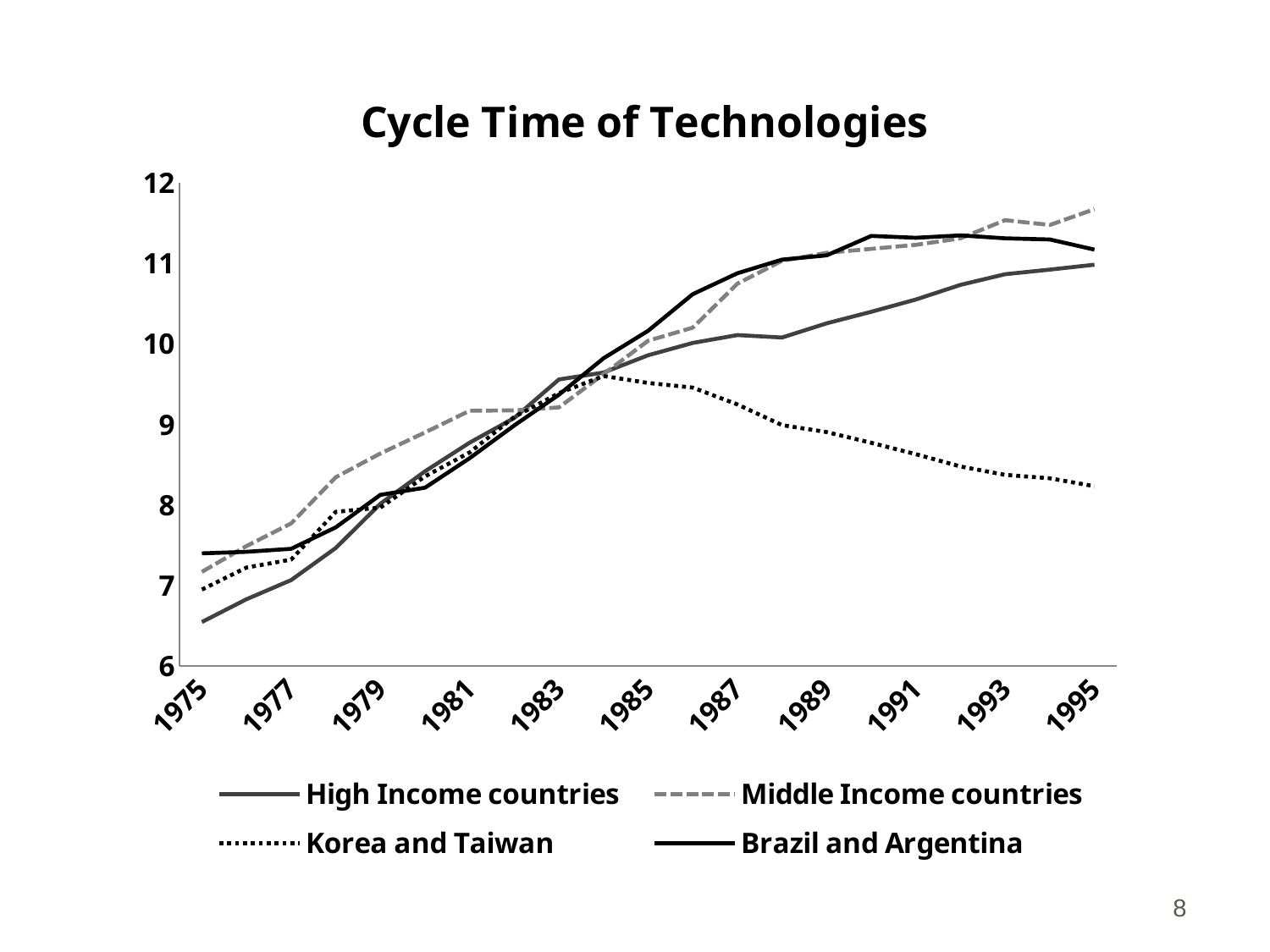
What kind of chart is shown on the slide? line chart Is the value for High Income countries in 1975 greater or less than 7? less Which series has the highest value in 1995? Middle Income countries In 1995, which is larger: High Income countries or Korea and Taiwan? High Income countries Is the value for Korea and Taiwan in 1995 greater or less than 9? less Which series has the lowest value in 1995? Korea and Taiwan Does the High Income countries line generally rise or fall from 1975 to 1995? rise What is the title of the chart? Cycle Time of Technologies Is the value for Middle Income countries in 1995 greater or less than 11? greater Which series has the lowest value in 1975? High Income countries How many series does the legend list? 4 Which series is drawn with a dotted line? Korea and Taiwan